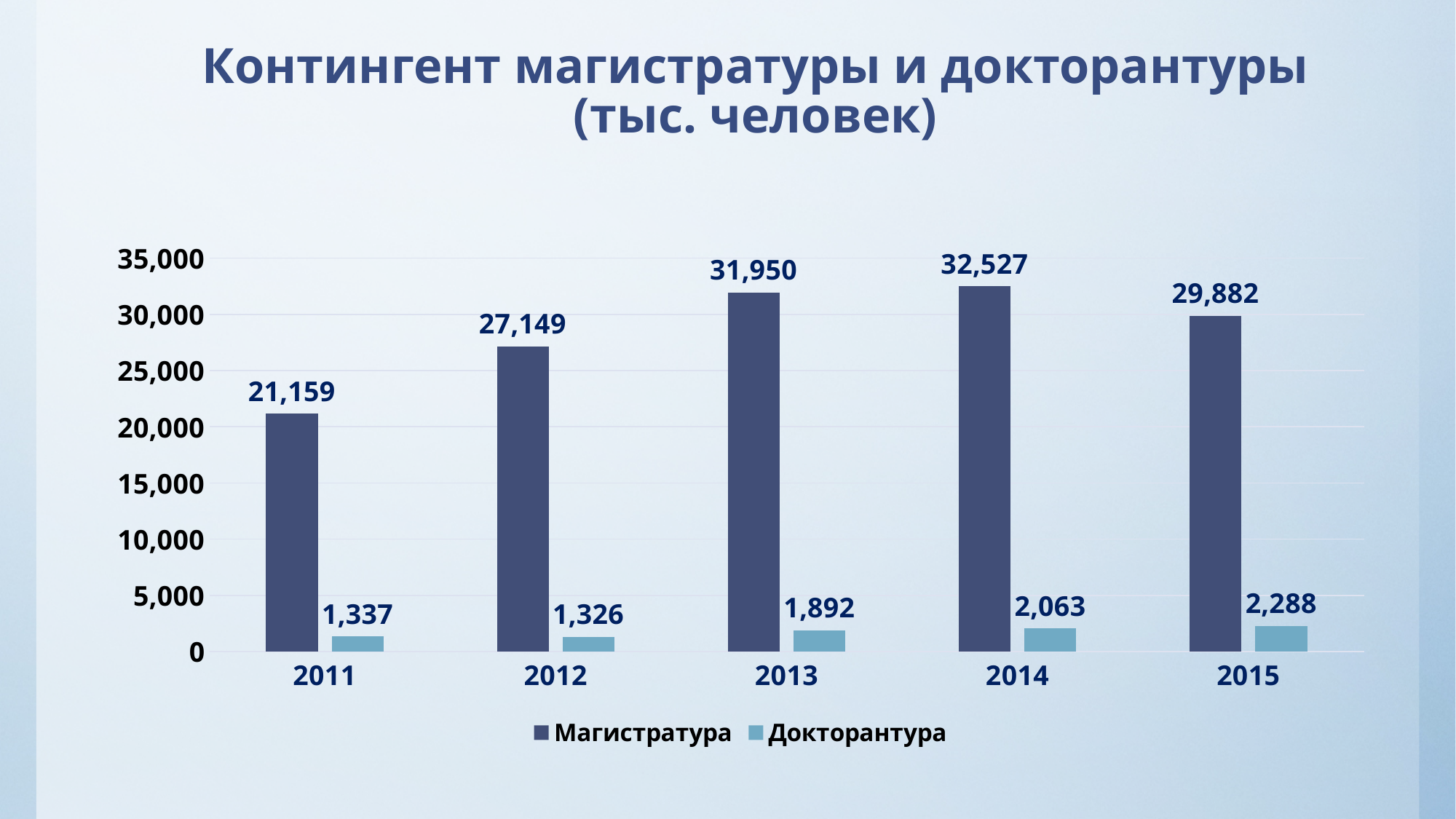
In which year is the Магистратура value highest? 2014 How many years are shown on the x axis? 5 What is the difference between the Магистратура values for 2014 and 2015? 2,645 In which year is the Докторантура value lowest? 2012 Does the Докторантура value rise or fall from 2012 to 2015? rise What is the value for Магистратура in 2013? 31,950 What kind of chart is shown on the slide? bar chart How many series does the legend list? 2 Which is larger: the Докторантура value for 2013 or for 2014? 2014 What is the value for Докторантура in 2015? 2,288 Is the Магистратура value for 2012 greater or less than 25,000? greater What is the title of the chart? Контингент магистратуры и докторантуры (тыс. человек)